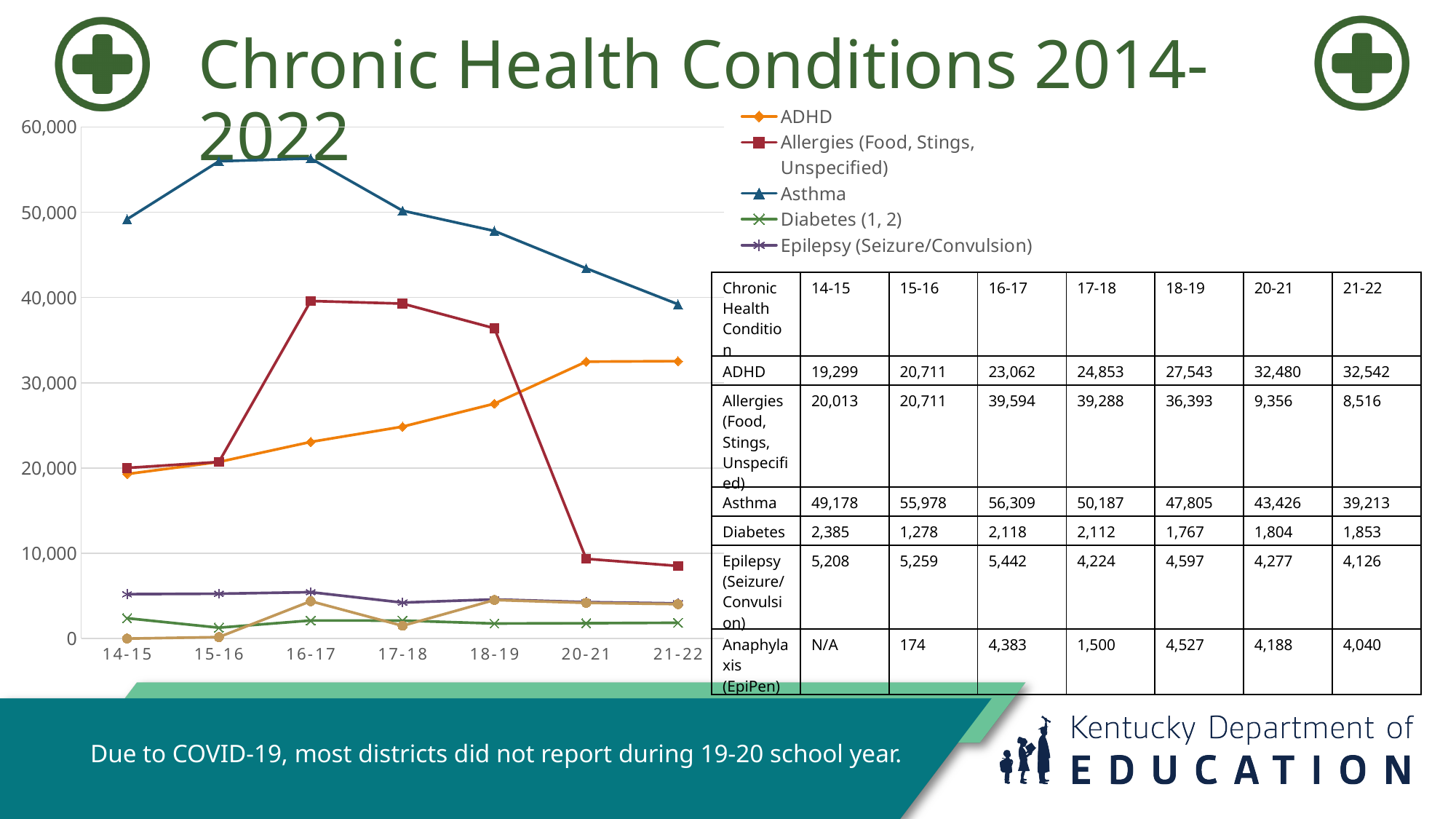
Does the ADHD series rise or fall from 14-15 to 21-22? rise What type of chart is shown on the slide? line chart How many series does the chart legend list? 5 What is the Asthma value for 16-17? 56,309 In which school year is the Asthma value highest? 16-17 What is the Allergies (Food, Stings, Unspecified) value for 20-21? 9,356 What is the ADHD value for 21-22? 32,542 Which is larger in 18-19, ADHD or Allergies (Food, Stings, Unspecified)? Allergies (Food, Stings, Unspecified) What is the difference between the Asthma value and the ADHD value in 21-22? 6,671 Is the Asthma value for 20-21 greater or less than 40,000? greater In which school year is the Allergies (Food, Stings, Unspecified) value lowest? 21-22 How many school-year categories are shown on the x axis? 7